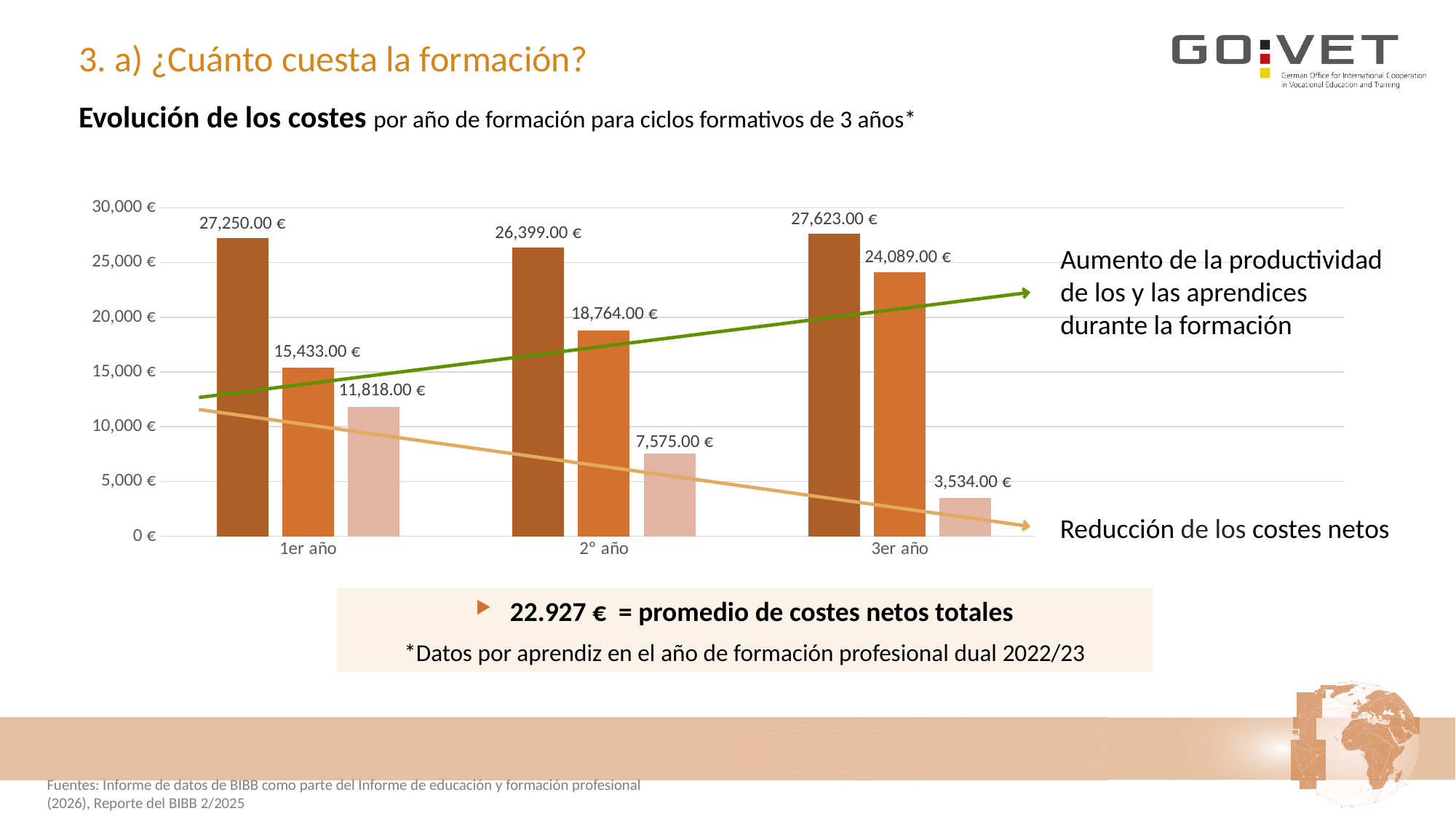
What is the value of the light pink (third) bar for 1er año? 11,818.00 € How many year categories are shown on the x axis? 3 What is the value of the dark brown (first) bar for 1er año? 27,250.00 € Is the value of the light pink (third) bar for 2° año greater or less than 10,000 €? less What is the difference between the light pink bar for 1er año and the light pink bar for 2° año? 4,243.00 € What is the value of the light pink (third) bar for 3er año? 3,534.00 € What is the value of the orange (middle) bar for 2° año? 18,764.00 € What kind of chart is shown on the slide? bar chart Which year has the highest value for the dark brown (first) bar? 3er año Which year has the lowest value for the light pink (third) bar? 3er año Which is larger: the orange bar for 1er año or the orange bar for 2° año? 2° año What is the difference between the dark brown bar and the orange bar for 3er año? 3,534.00 €